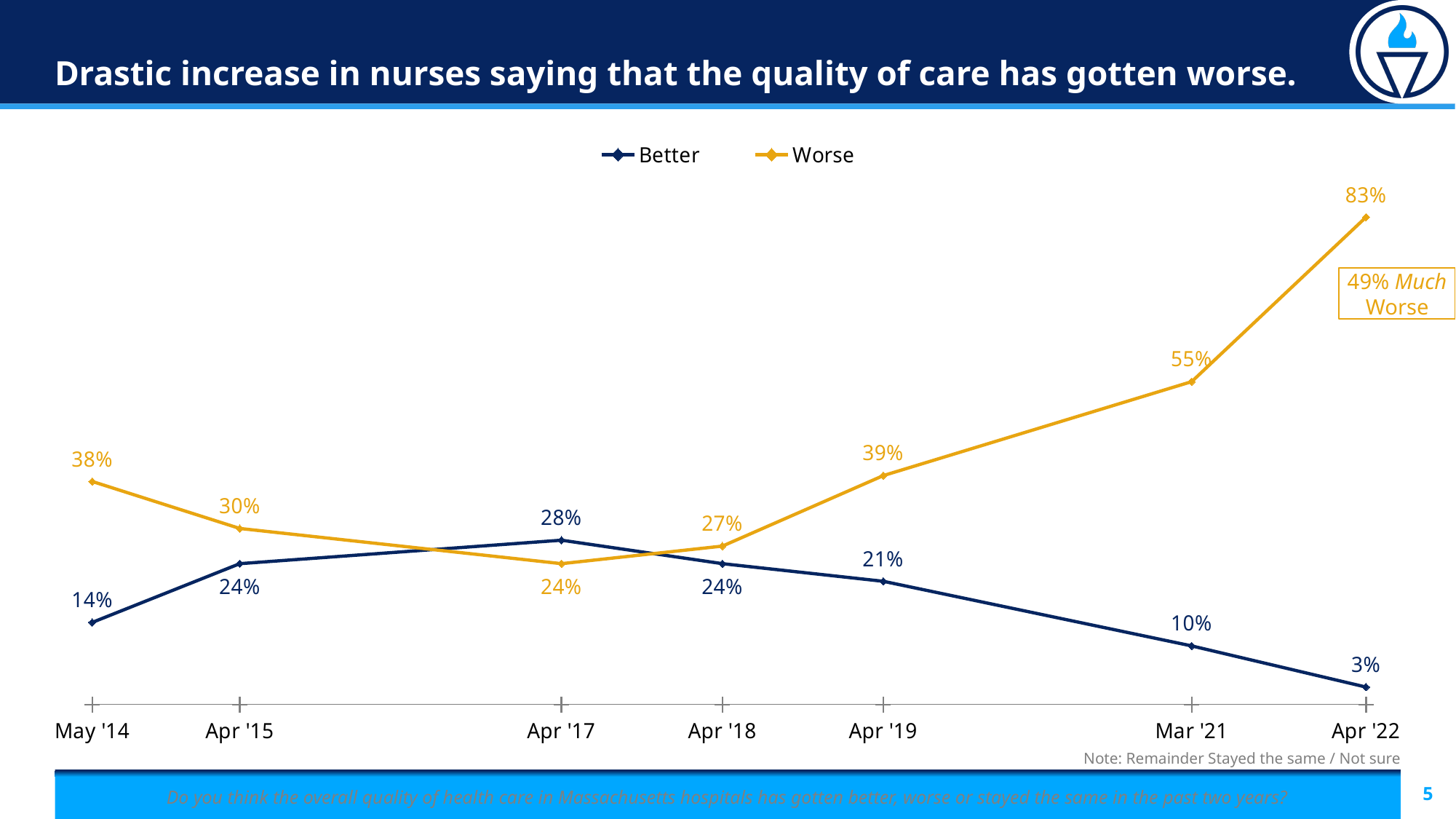
What is the value for Worse in Apr '17? 24% What is the difference between Worse and Better in Apr '22? 80 percentage points In Apr '15, which series has the larger value, Better or Worse? Worse At which time point is the Worse series lowest? Apr '17 Does the Better series rise or fall from Apr '17 to Apr '22? fall What is the value for Worse in Apr '22? 83% What share of nurses said the quality of care was 'Much Worse' in Apr '22, according to the callout box? 49% What is the value for Better in May '14? 14% At which time point is the Better series highest? Apr '17 How many series does the legend list? 2 How many time points are plotted along the x axis? 7 What kind of chart is shown on the slide? line chart